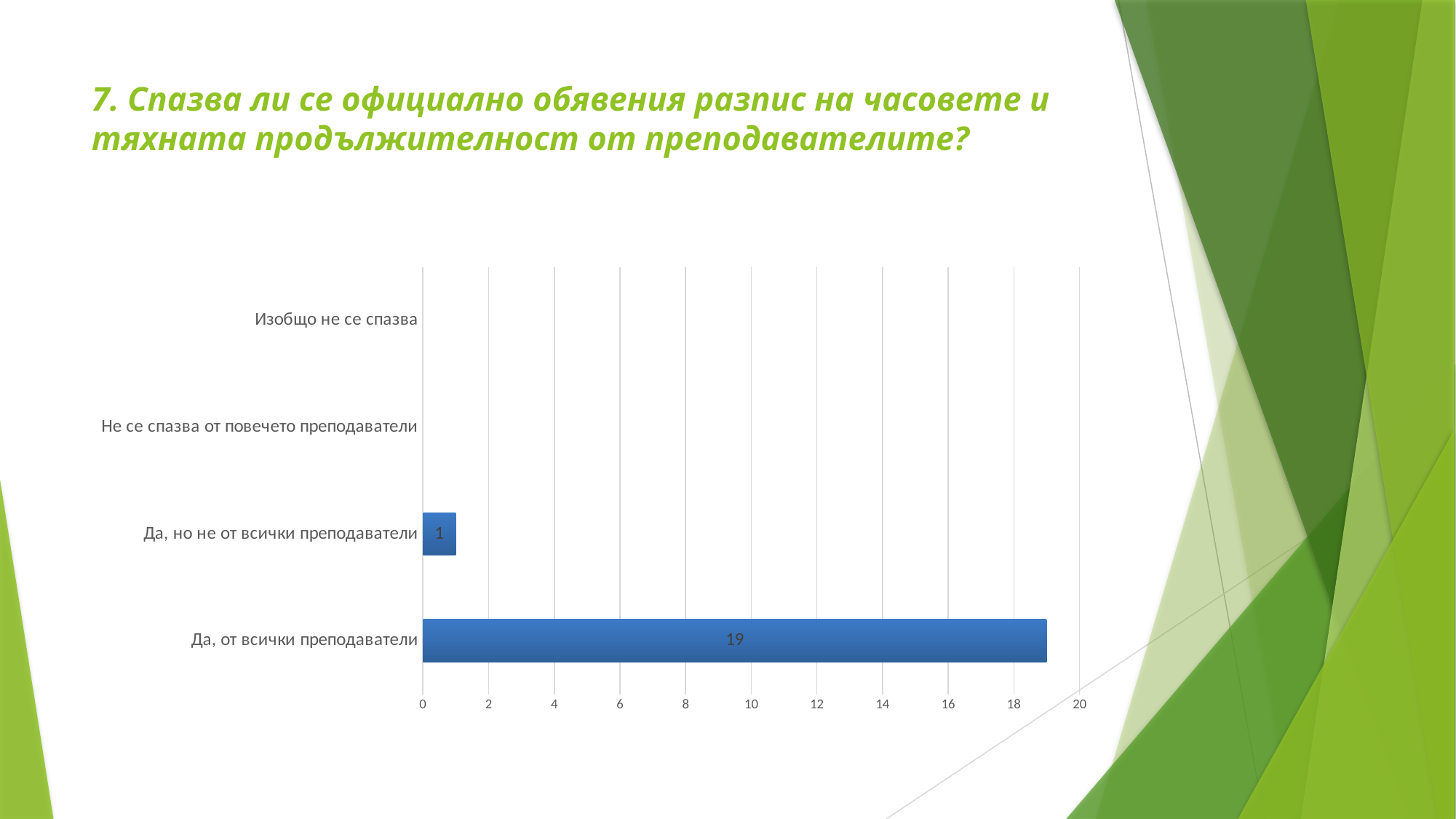
What is the total of the values shown on the chart? 20 Which is larger: the value for "Да, от всички преподаватели" or for "Да, но не от всички преподаватели"? Да, от всички преподаватели What is the difference between the values for "Да, от всички преподаватели" and "Да, но не от всички преподаватели"? 18 What is the maximum value shown on the horizontal axis? 20 What colour are the bars in the chart? blue What kind of chart is shown on the slide? bar chart What is the value for "Да, но не от всички преподаватели"? 1 Which category has the highest value? Да, от всички преподаватели What is the value for "Да, от всички преподаватели"? 19 Is the value for "Да, от всички преподаватели" greater or less than 10? greater How many categories are shown on the chart? 4